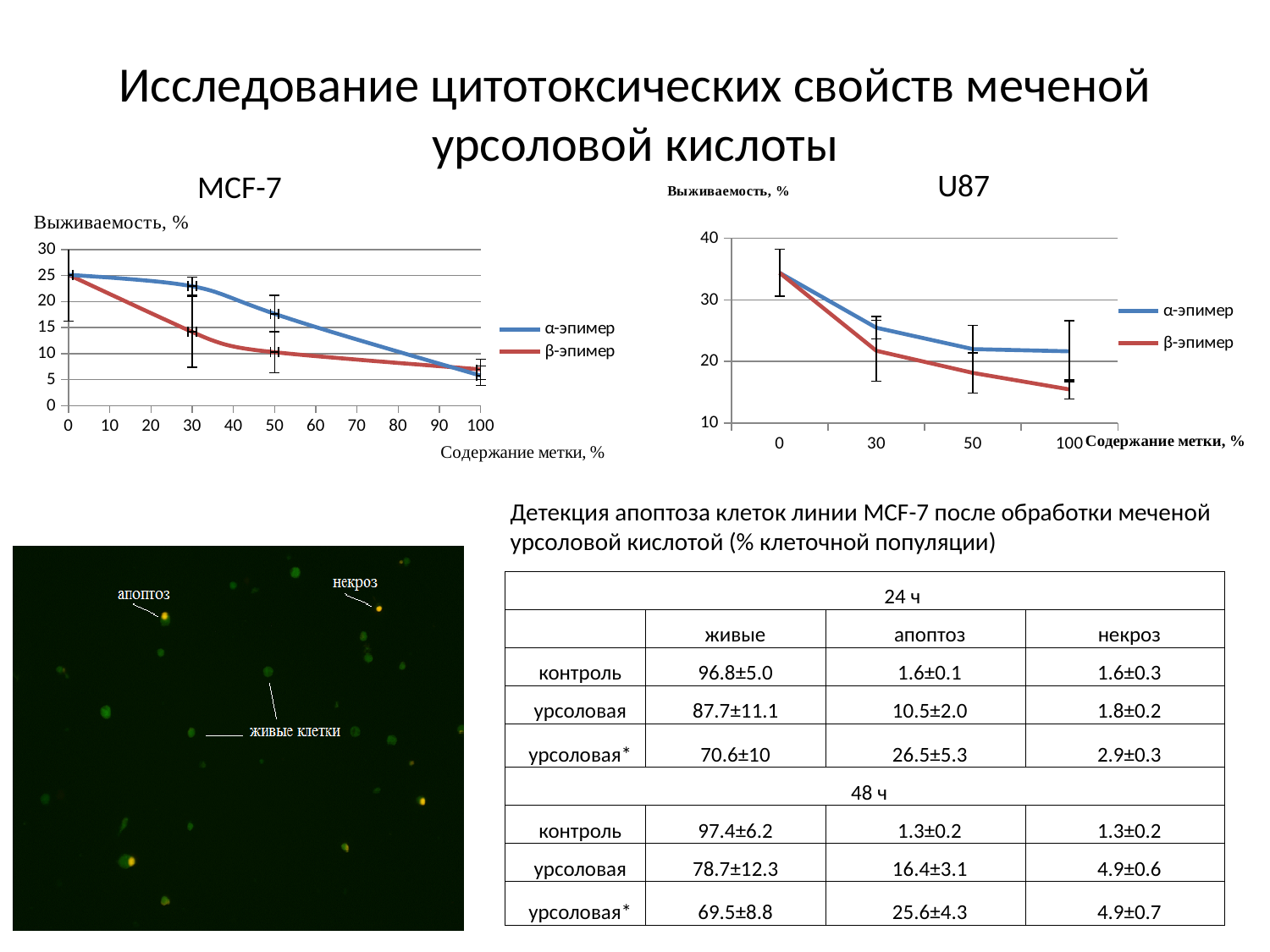
On the MCF-7 chart, do the survival values rise or fall as the label content increases along the x axis? fall What kind of chart is the MCF-7 chart? line chart On the U87 chart, do the values of the β-эпимер series rise or fall along the x axis? fall On the U87 chart, is the value for β-эпимер at 100% label content greater or less than 20? less On the MCF-7 chart, is the value for α-эпимер at 100% label content greater or less than 10? less What are the two legend entries on the MCF-7 chart? α-эпимер and β-эпимер How many series does the legend of the U87 chart list? 2 On the MCF-7 chart, is the value for α-эпимер at 30% label content greater or less than 20? greater On the MCF-7 chart, which series has the larger value at 30% label content, α-эпимер or β-эпимер? α-эпимер On the U87 chart, which series has the larger value at 100% label content, α-эпимер or β-эпимер? α-эпимер